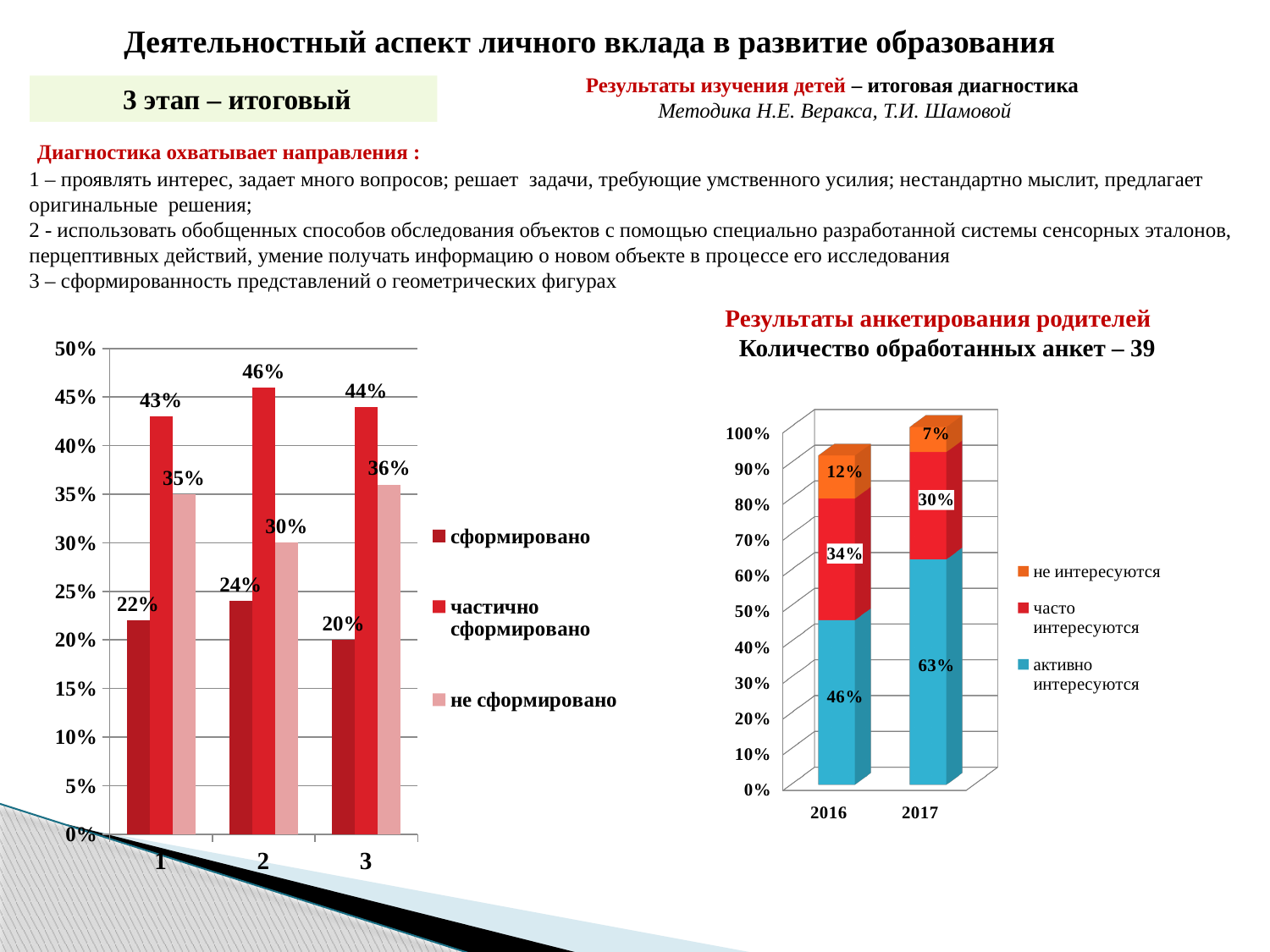
On the left chart, what is the value of 'сформировано' for category 3? 20% On the right chart (Результаты анкетирования родителей), what is the value of 'не интересуются' for 2016? 12% On the right chart (Результаты анкетирования родителей), what is the total of the stacked bar for 2017? 100% On the left chart, what is the value of 'частично сформировано' for category 2? 46% What kind of chart is the left chart? bar chart On the left chart, how many series does the legend list? 3 On the left chart, which category has the highest value for 'сформировано'? 2 On the left chart, which is larger for category 3: 'не сформировано' or 'сформировано'? не сформировано On the right chart (Результаты анкетирования родителей), how many categories are shown on the x axis? 2 On the right chart (Результаты анкетирования родителей), what is the value of 'активно интересуются' for 2017? 63% On the left chart, what is the difference between 'частично сформировано' and 'сформировано' for category 1? 21% On the left chart, what is the value of 'не сформировано' for category 1? 35%